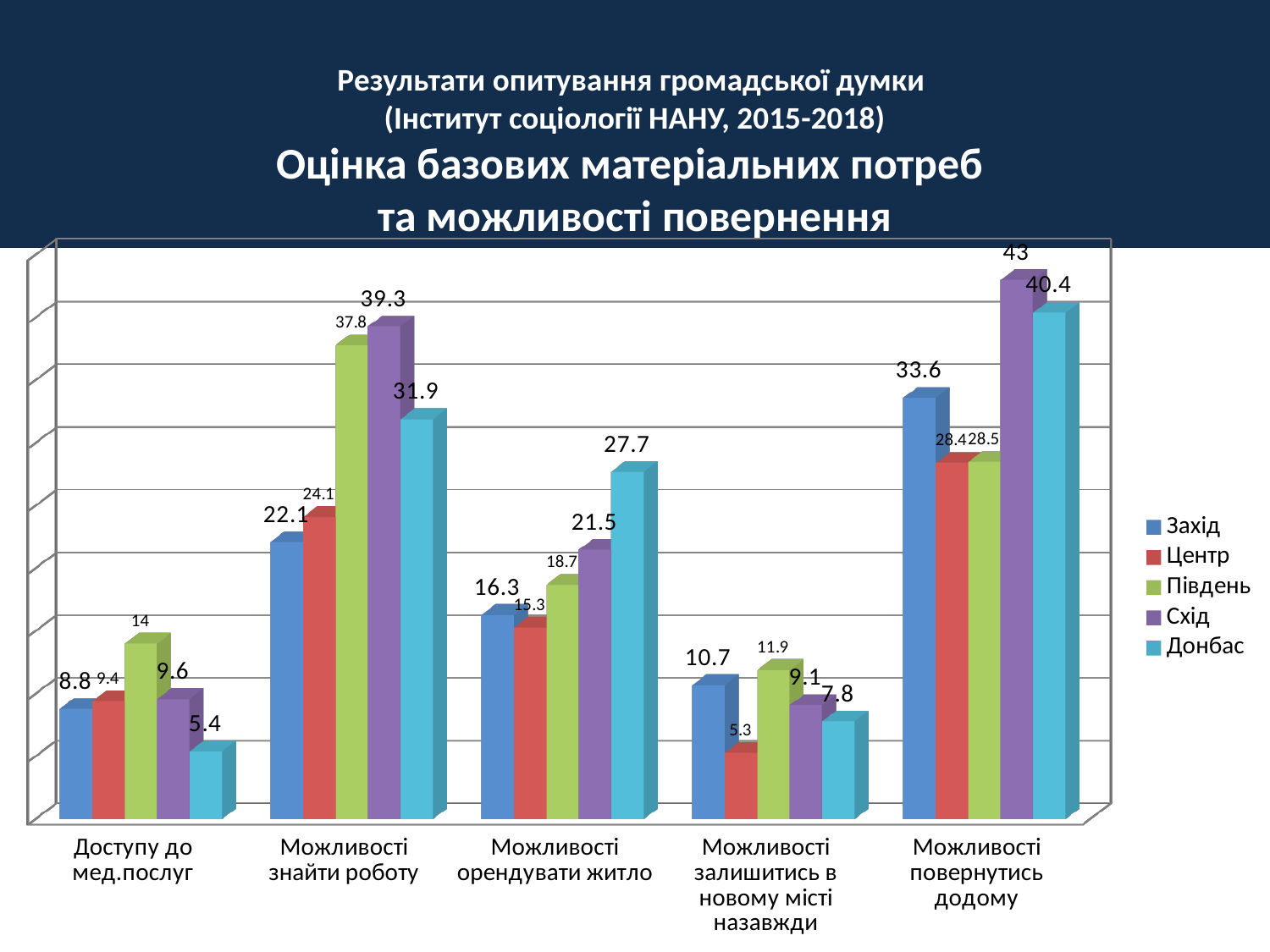
What is the value for Донбас in the category 'Можливості орендувати житло'? 27.7 What type of chart is shown on the slide? bar chart What is the value for Схід in the category 'Можливості повернутись додому'? 43 Which region has the highest value in the category 'Можливості знайти роботу'? Схід Which region has the lowest value in the category 'Доступу до мед.послуг'? Донбас Which legend entry is shown in purple? Схід How many series does the legend list? 5 What is the difference between the values for Схід and Захід in the category 'Можливості повернутись додому'? 9.4 What is the value for Центр in the category 'Можливості залишитись в новому місті назавжди'? 5.3 How many categories are shown on the x axis? 5 What is the difference between the values for Південь and Донбас in the category 'Доступу до мед.послуг'? 8.6 In the category 'Можливості орендувати житло', which is larger: the value for Захід or the value for Центр? Захід